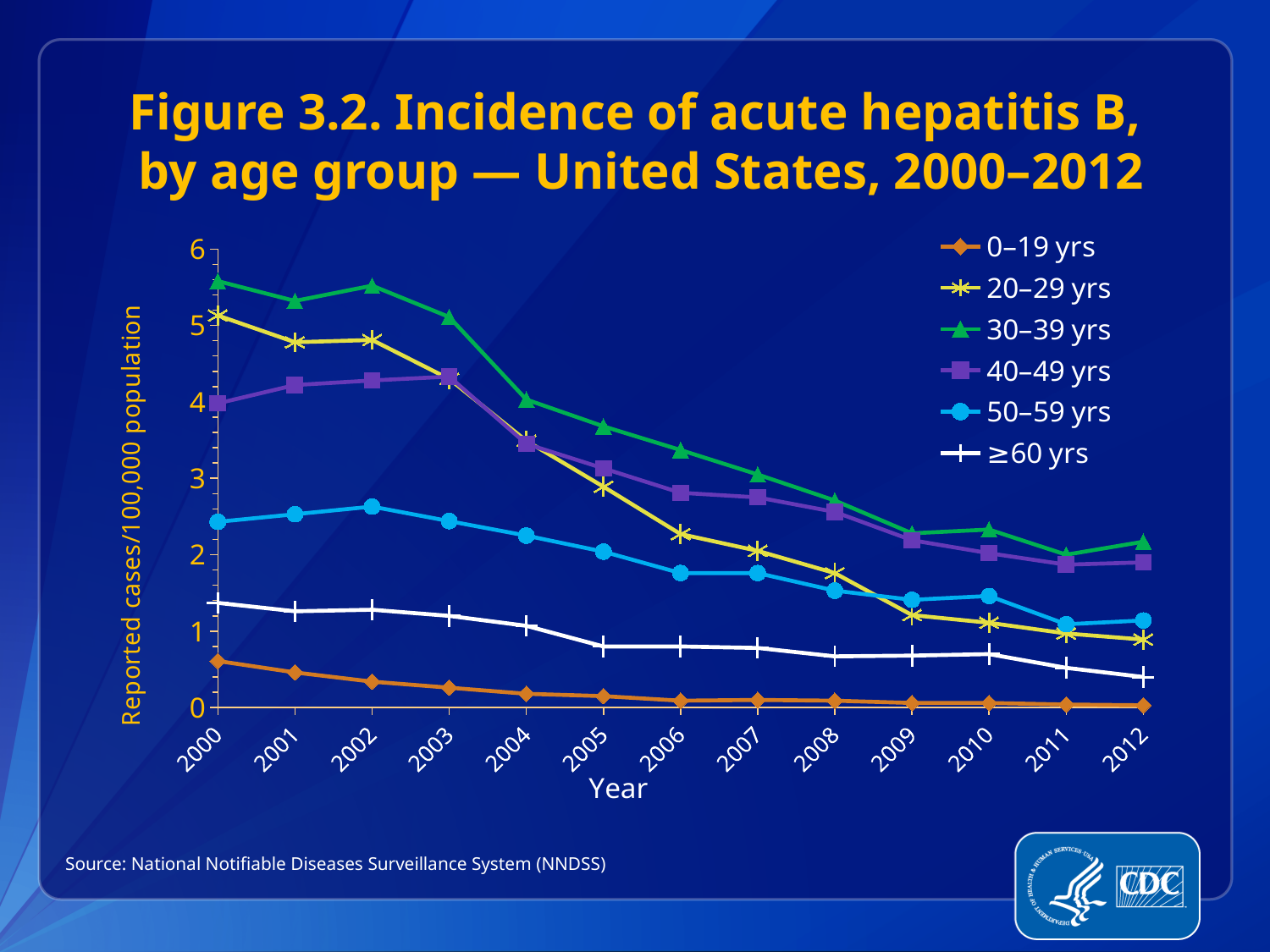
Which age group has the highest incidence in 2000? 30–39 yrs How many series does the legend list? 6 What kind of chart is shown on the slide? Line chart Is the value for the 50–59 yrs group in 2000 greater or less than 2? greater Is the value for the 30–39 yrs group in 2000 greater or less than 5? greater Does the incidence for the 30–39 yrs group rise or fall from 2000 to 2012? Fall In 2005, which is larger: the value for the 30–39 yrs group or the 50–59 yrs group? 30–39 yrs Which age group has the lowest incidence in 2012? 0–19 yrs What is the title of the chart? Figure 3.2. Incidence of acute hepatitis B, by age group — United States, 2000–2012 How many years are plotted along the x axis? 13 Is the value for the 0–19 yrs group in 2012 greater or less than 1? less What is the label of the y axis? Reported cases/100,000 population